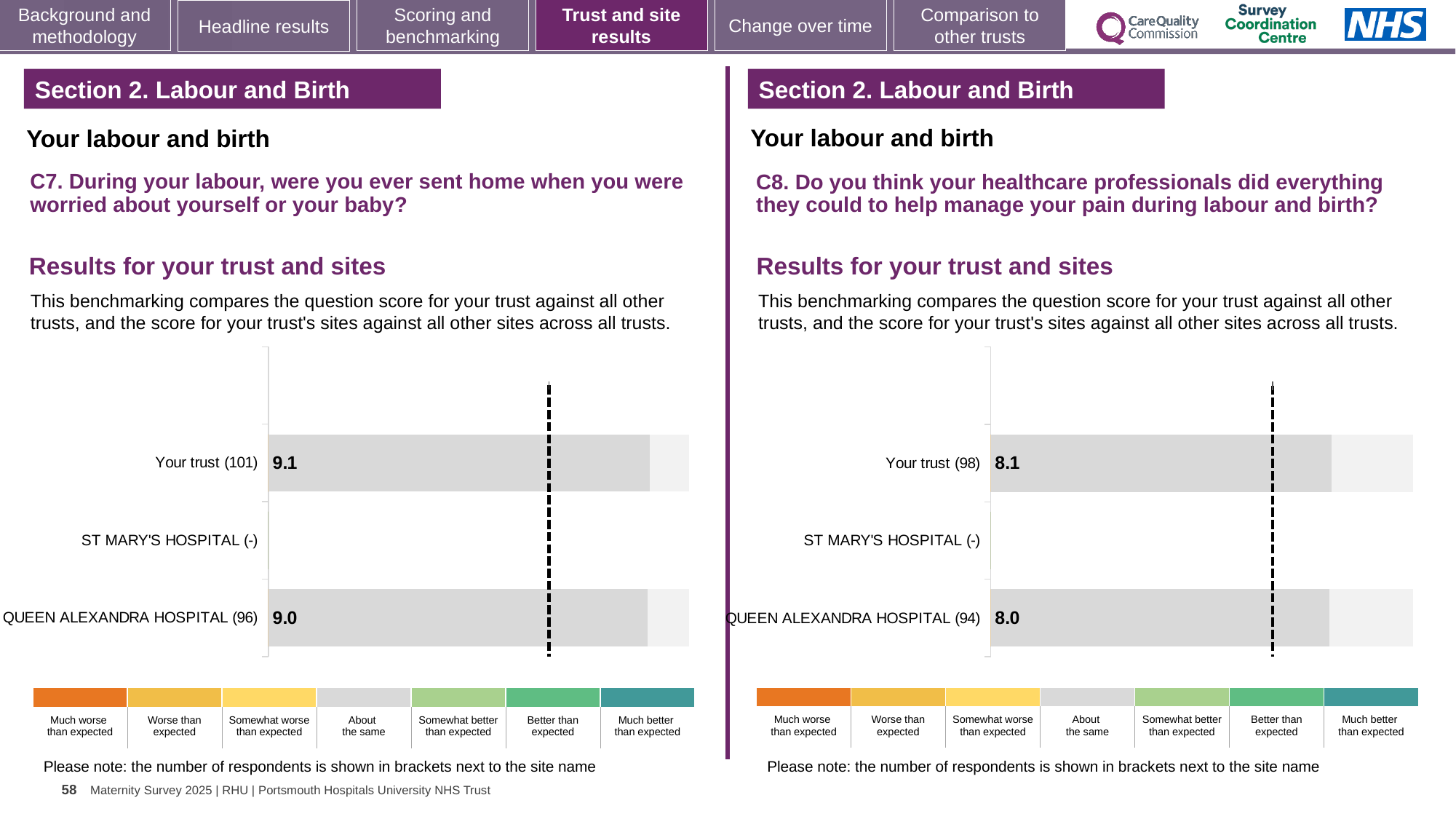
In the C7 chart (left), what is the score for Queen Alexandra Hospital? 9.0 In the C8 chart (right), how many respondents are shown in brackets for Queen Alexandra Hospital? 94 In the C8 chart (right), what is the score for Your trust? 8.1 In the C7 chart (left), what is the difference between the Your trust score and the Queen Alexandra Hospital score? 0.1 In the C7 chart (left), what is the score for Your trust? 9.1 How many site/trust categories are listed on the C7 chart (left)? 3 In the C7 chart (left), how many respondents are shown in brackets for Your trust? 101 What kind of chart is used on the C8 chart (right)? Bar chart How many benchmark bands does the legend below the C8 chart (right) list? 7 In the C8 chart (right), what is the score for Queen Alexandra Hospital? 8.0 In the C8 chart (right), what is the difference between the Your trust score and the Queen Alexandra Hospital score? 0.1 In the C7 chart (left), which category has no score bar shown? ST MARY'S HOSPITAL (-)